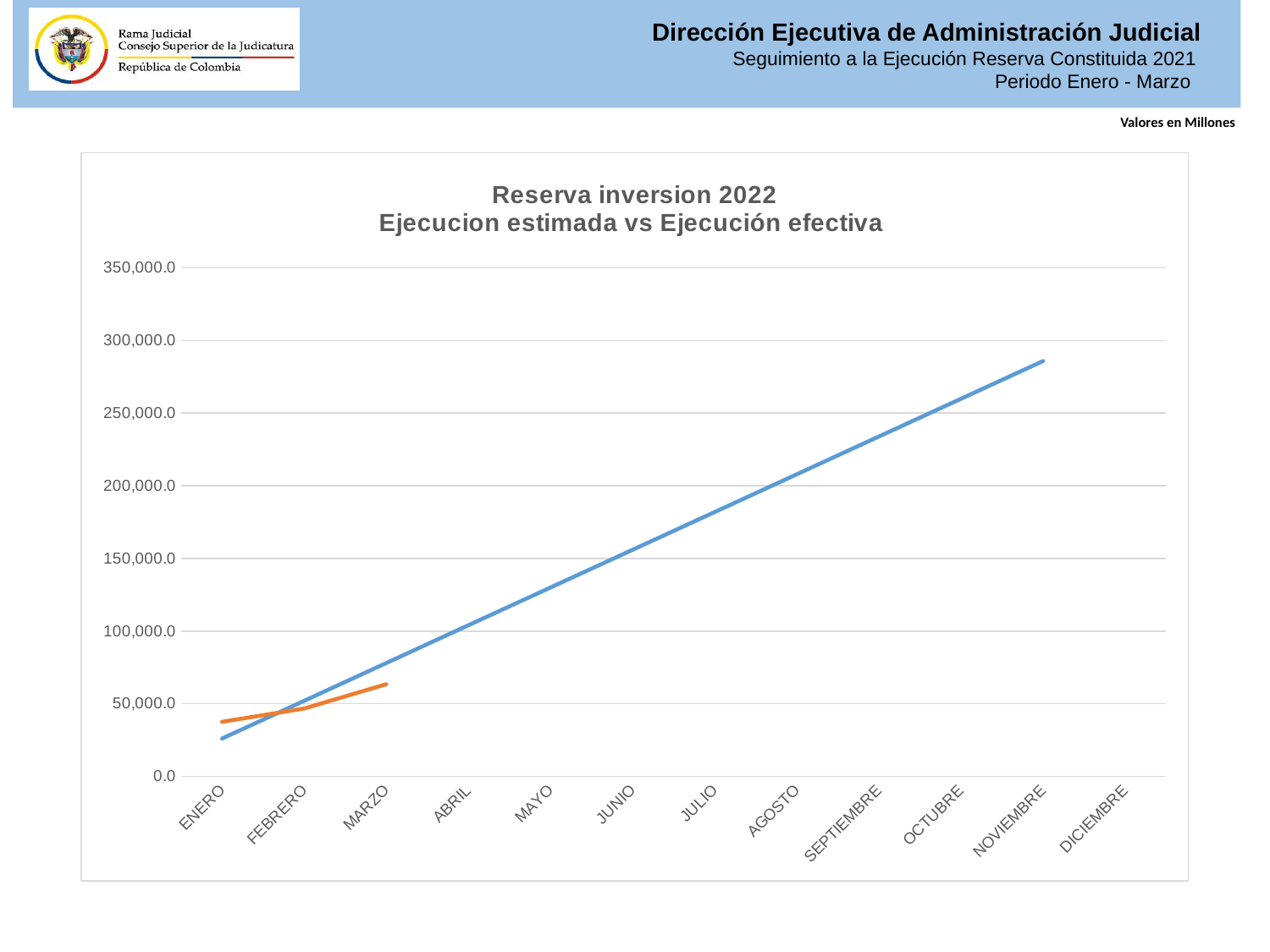
Is the value of the blue line at NOVIEMBRE greater or less than 300,000.0? less Is the value of the orange line at MARZO greater or less than 50,000.0? greater What kind of chart is shown on the slide? line chart Does the orange line rise or fall from ENERO to MARZO? rise Which is the last month on the x axis where the blue line has a plotted point? NOVIEMBRE Is the value of the blue line at JULIO greater or less than 150,000.0? greater At ENERO, which line has the higher value, the blue line or the orange line? the orange line How many months are listed along the x axis of the chart? 12 What is the title of the chart? Reserva inversion 2022 Ejecucion estimada vs Ejecución efectiva Does the blue line rise or fall from ENERO to NOVIEMBRE? rise